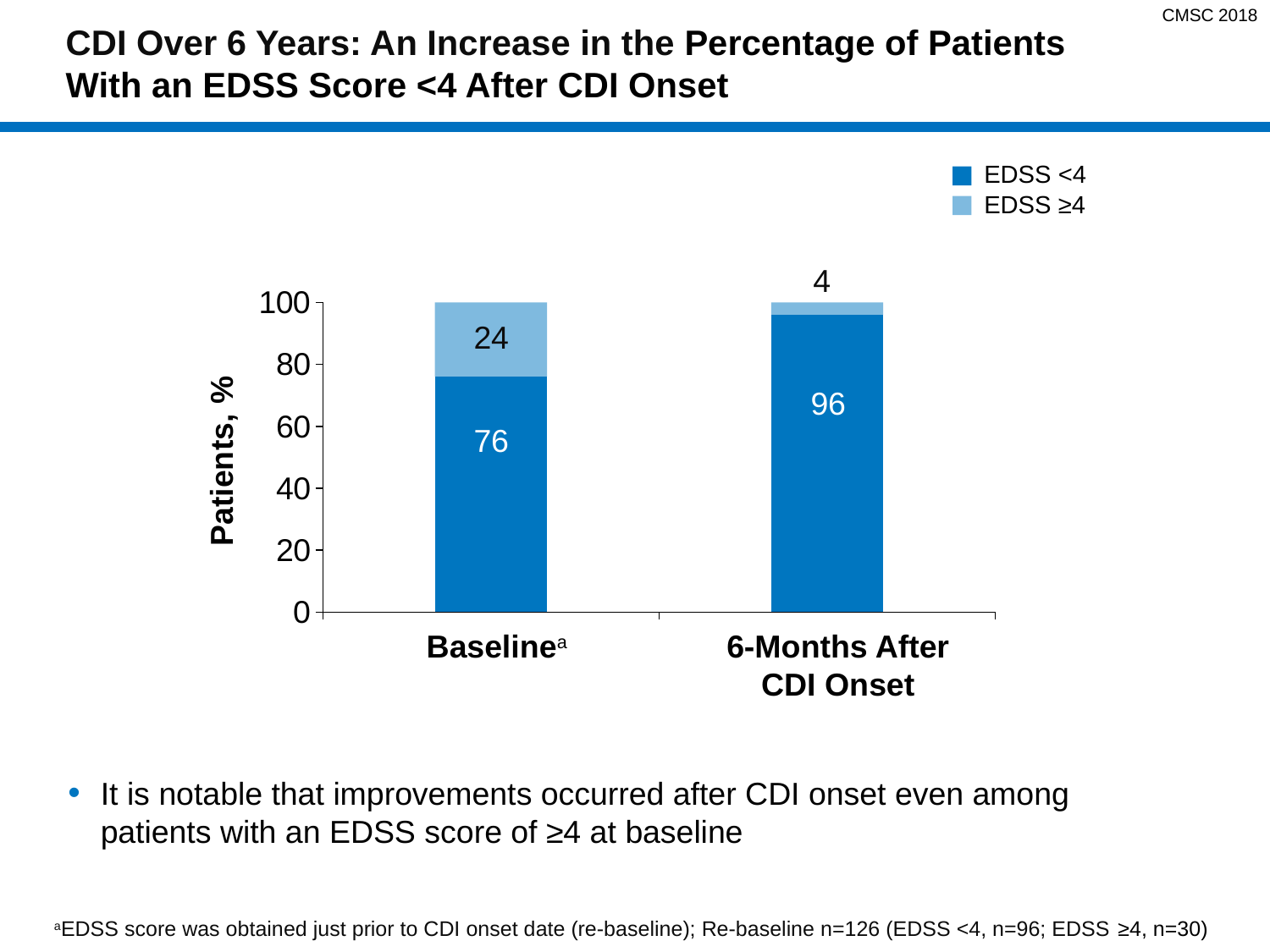
Is the EDSS ≥4 percentage larger at Baseline or at 6-Months After CDI Onset? Baseline What percentage of patients had an EDSS score <4 at 6-Months After CDI Onset? 96 What percentage of patients had an EDSS score <4 at Baseline? 76 What kind of chart is shown on the slide? Stacked bar chart Which time point has the lower percentage of patients with EDSS ≥4? 6-Months After CDI Onset What is the total of the stacked bar for Baseline? 100 By how many percentage points did the EDSS <4 share increase from Baseline to 6-Months After CDI Onset? 20 What percentage of patients had an EDSS score ≥4 at 6-Months After CDI Onset? 4 How many time points (categories) are shown on the x axis? 2 What percentage of patients had an EDSS score ≥4 at Baseline? 24 Which time point has the higher percentage of patients with EDSS <4? 6-Months After CDI Onset How many series does the legend list? 2